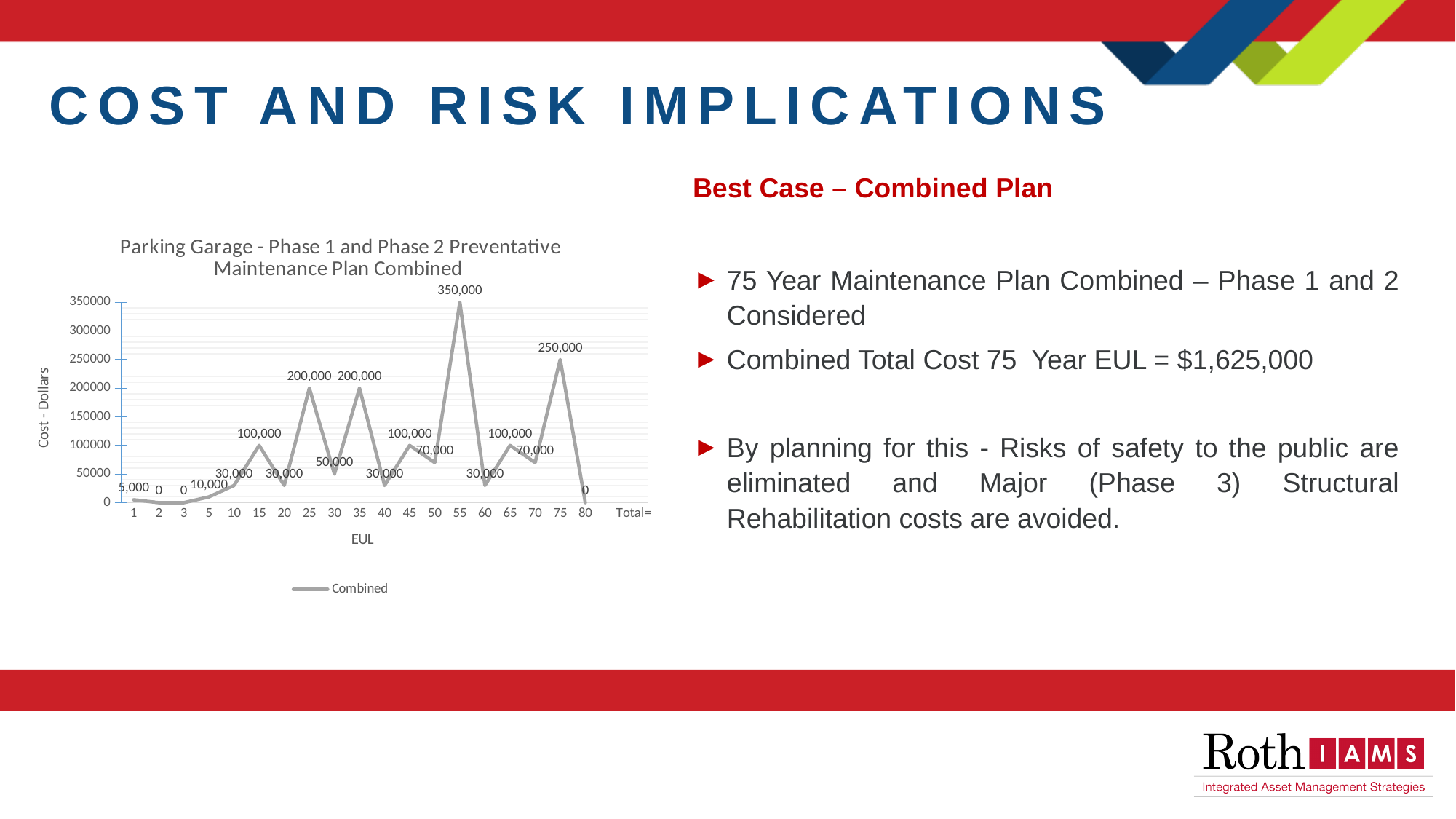
What is the name of the series shown in the legend? Combined What is the title of the vertical axis? Cost - Dollars What kind of chart is shown on the slide? line chart What is the Combined cost at EUL 1? 5,000 What is the Combined cost at EUL 75? 250,000 How many series does the legend list? 1 At which EUL value does the Combined cost reach its highest point? 55 What is the difference between the Combined cost at EUL 55 and at EUL 75? 100,000 What is the Combined cost at EUL 55? 350,000 Which has the larger Combined cost, EUL 25 or EUL 30? 25 How much higher is the Combined cost at EUL 15 than at EUL 10? 70,000 What is the Combined cost at EUL 50? 70,000